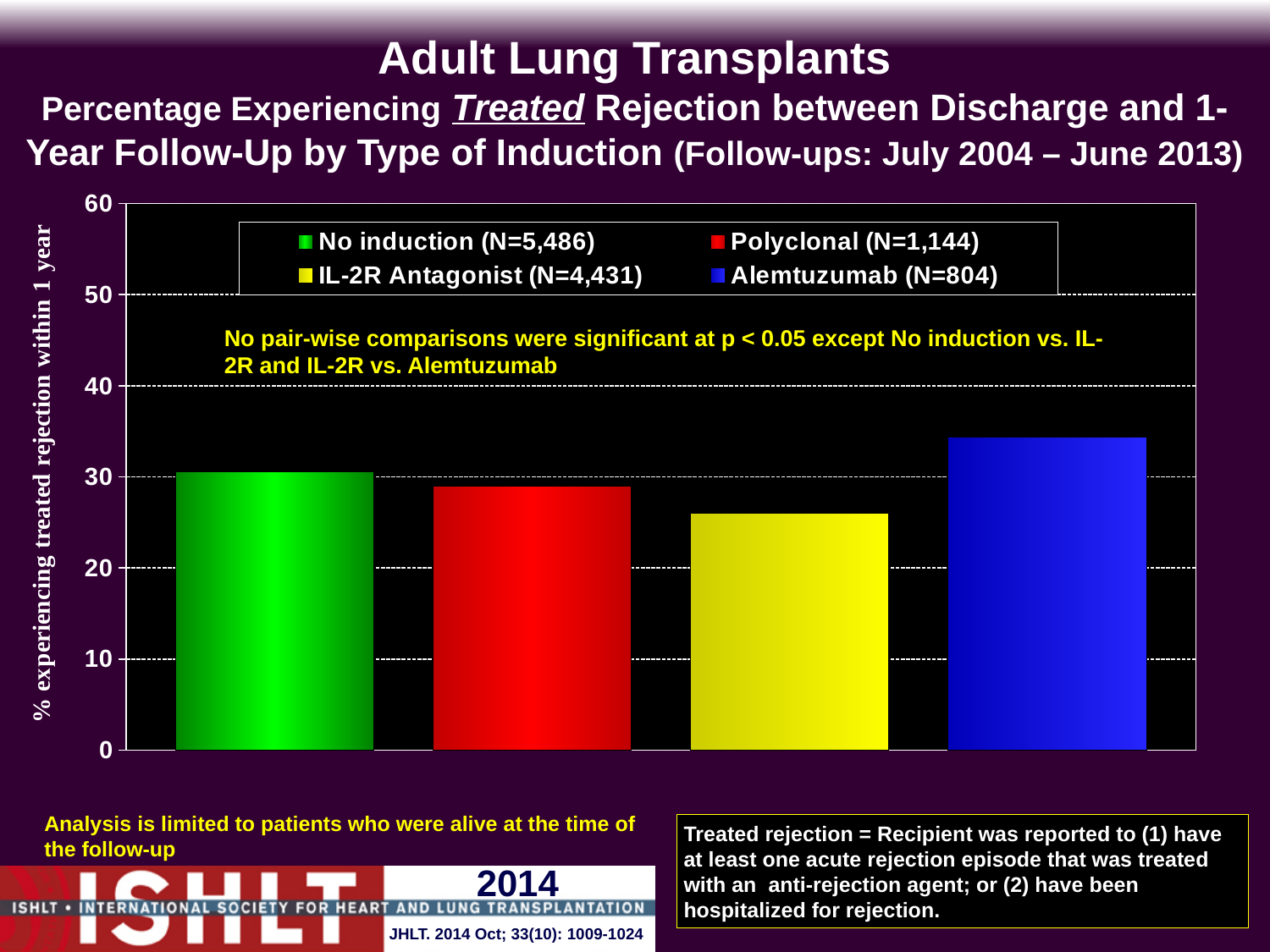
Is the value for Alemtuzumab greater or less than 40? less Is the value for Polyclonal greater or less than 20? greater Which is larger, the value for No induction or the value for IL-2R Antagonist? No induction What kind of chart is shown on the slide? Bar chart How many bars are plotted in the chart? 4 What colour is the bar for Alemtuzumab? Blue Which induction type has the lowest percentage experiencing treated rejection within 1 year? IL-2R Antagonist Which induction type has the highest percentage experiencing treated rejection within 1 year? Alemtuzumab Is the value for Alemtuzumab greater or less than 30? greater What is the N for the Polyclonal group shown in the legend? 1,144 How many series does the legend list? 4